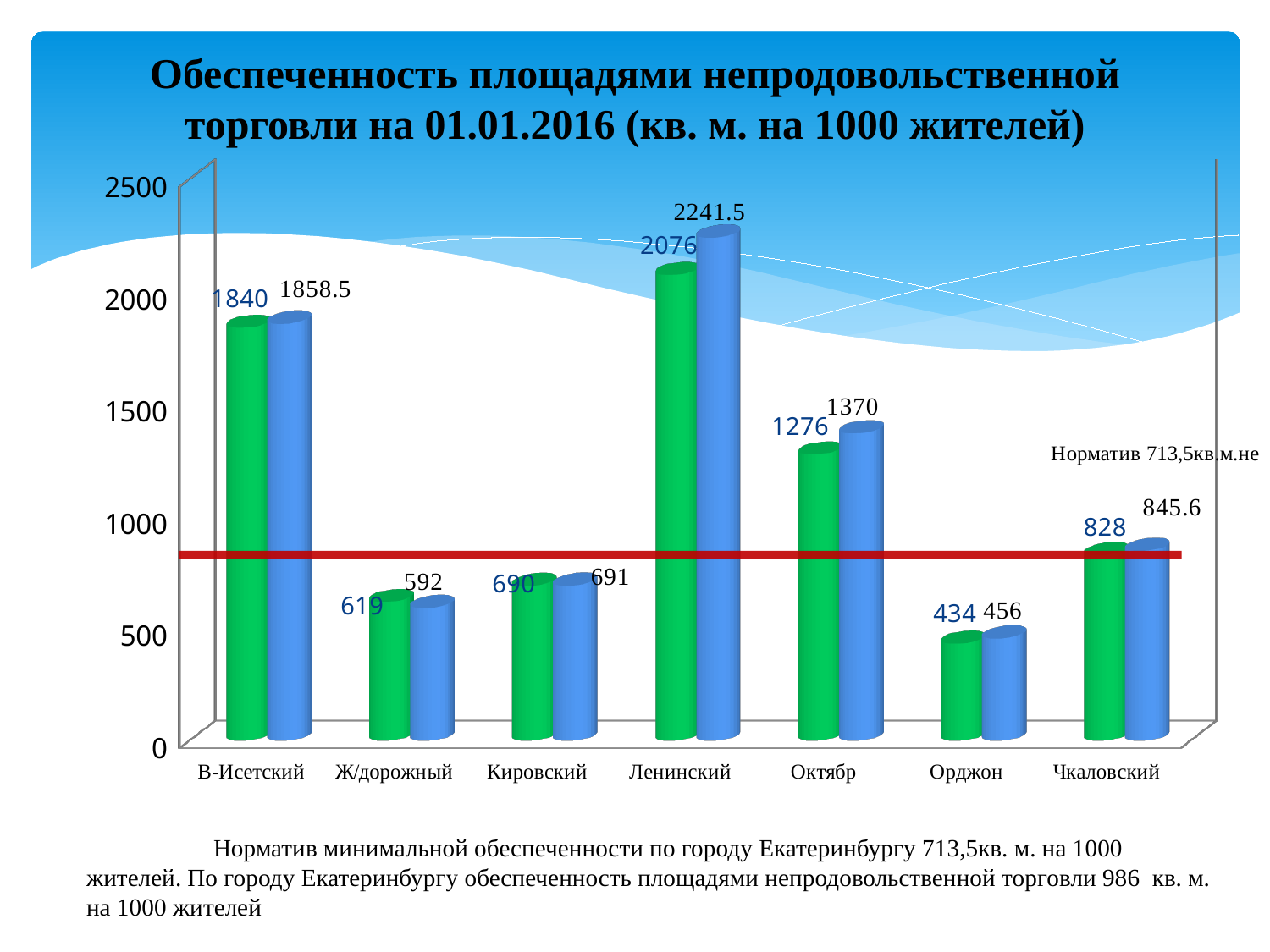
What is the value of the green bar for Орджон? 434 What is the value of the blue bar for Ленинский? 2241.5 How many districts (categories) are shown on the x axis of the chart? 7 Which is larger: the green bar for Ж/дорожный or the green bar for Кировский? Кировский What type of chart is shown on the slide? bar chart Is the value of the blue bar for Орджон greater or less than 500? less Which district has the lowest green bar? Орджон What is the value of the blue bar for Чкаловский? 845.6 What is the difference between the blue bar and the green bar for Октябр? 94 Which district has the highest blue bar? Ленинский What is the title of the chart? Обеспеченность площадями непродовольственной торговли на 01.01.2016 (кв. м. на 1000 жителей) What is the value of the green bar for В-Исетский? 1840